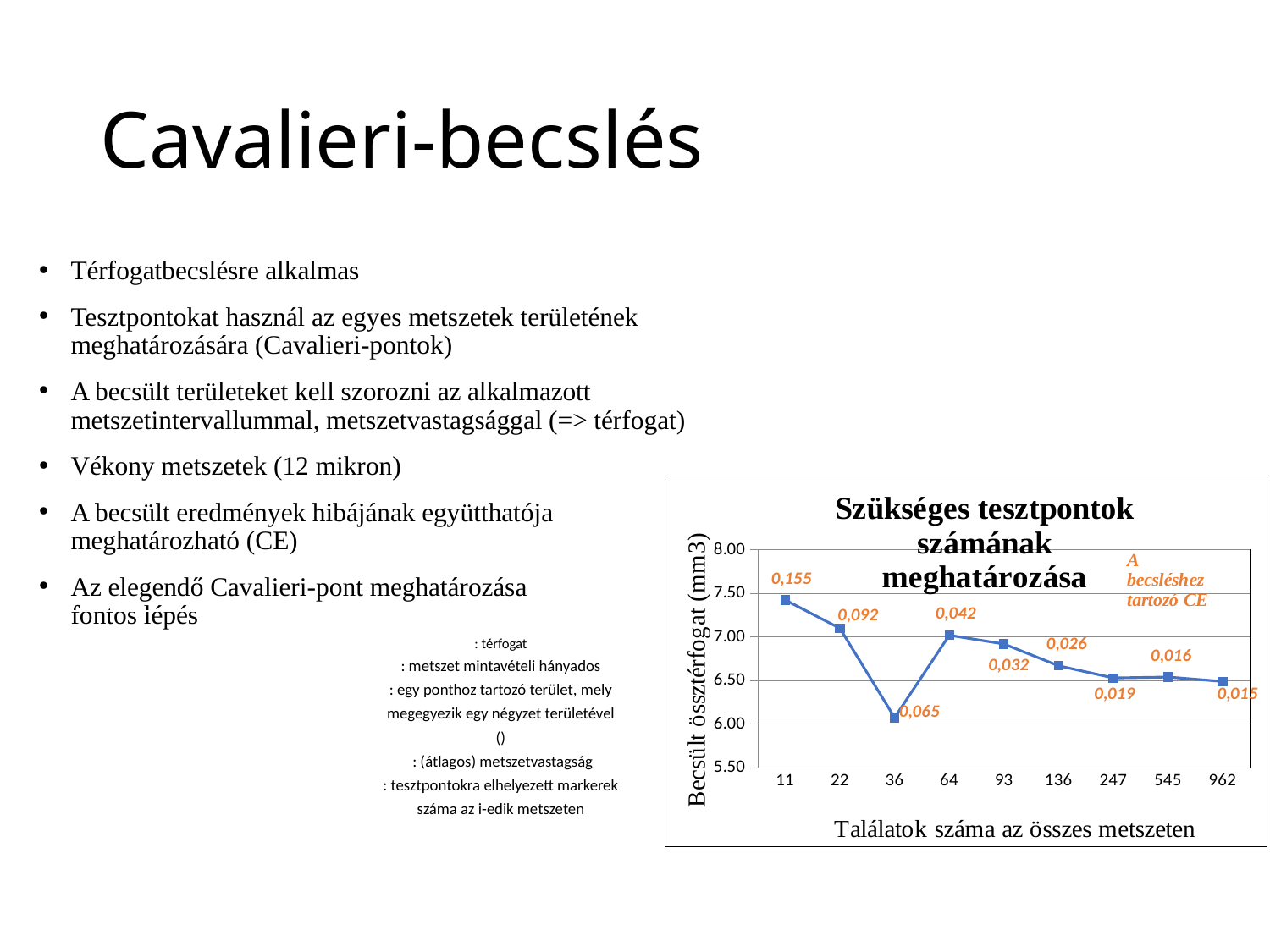
Is the value for 136 greater or less than 7.00? less What CE value is printed next to the point at 36? 0,065 From 64 to 247 on the x axis, do the plotted values rise or fall? fall Is the value for 36 greater or less than 6.50? less What is the title of the chart? Szükséges tesztpontok számának meghatározása At which x-axis category is the estimated total volume lowest? 36 At which x-axis category is the estimated total volume highest? 11 How many data points are plotted on the chart? 9 What kind of chart is shown on the slide? line chart Which has the larger estimated total volume, 11 or 22? 11 What is the label of the vertical axis of the chart? Becsült össztérfogat (mm3) Is the value for 11 greater or less than 7.00? greater